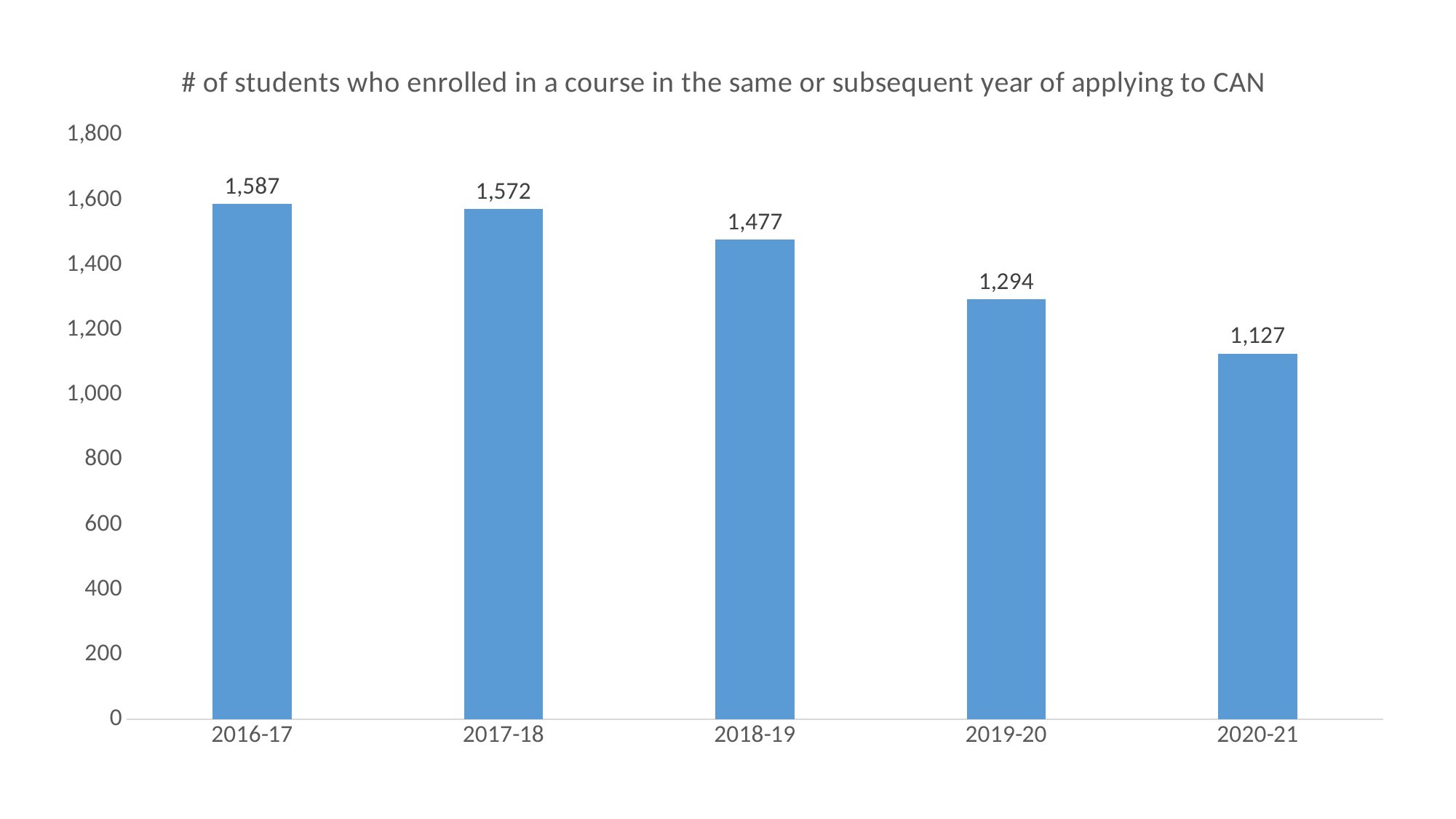
What is the value for 2020-21? 1,127 How many years are shown on the x axis? 5 What is the difference between the values for 2016-17 and 2020-21? 460 Is the value for 2019-20 greater or less than 1,200? greater What is the value for 2018-19? 1,477 What is the difference between the values for 2018-19 and 2019-20? 183 Do the values rise or fall from 2016-17 to 2020-21? fall What kind of chart is shown on the slide? bar chart Which is larger, the value for 2017-18 or the value for 2019-20? 2017-18 Which year has the lowest number of students? 2020-21 Which year has the highest number of students? 2016-17 What is the value for 2016-17? 1,587